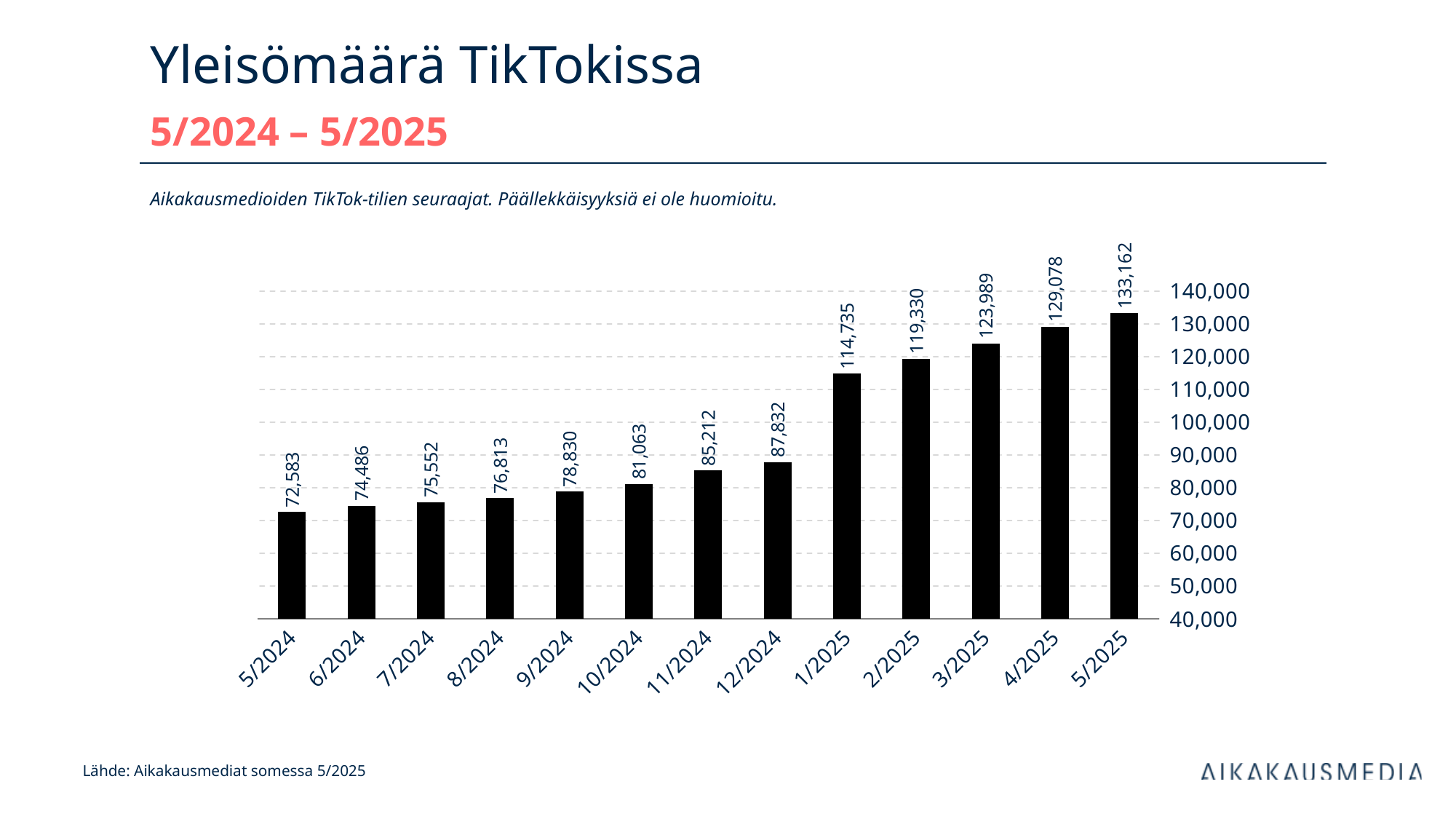
Which month has the lowest value? 5/2024 What kind of chart is shown on the slide? bar chart What is the value for 1/2025? 114,735 Is the value for 2/2025 greater or less than 110,000? greater What is the difference between the values for 1/2025 and 12/2024? 26,903 How many months are shown on the x axis? 13 Which is larger, the value for 3/2025 or the value for 11/2024? 3/2025 What is the value for 5/2024? 72,583 Which month has the highest value? 5/2025 Do the values rise or fall from 5/2024 to 5/2025? rise What is the difference between the values for 5/2025 and 5/2024? 60,579 What is the value for 10/2024? 81,063